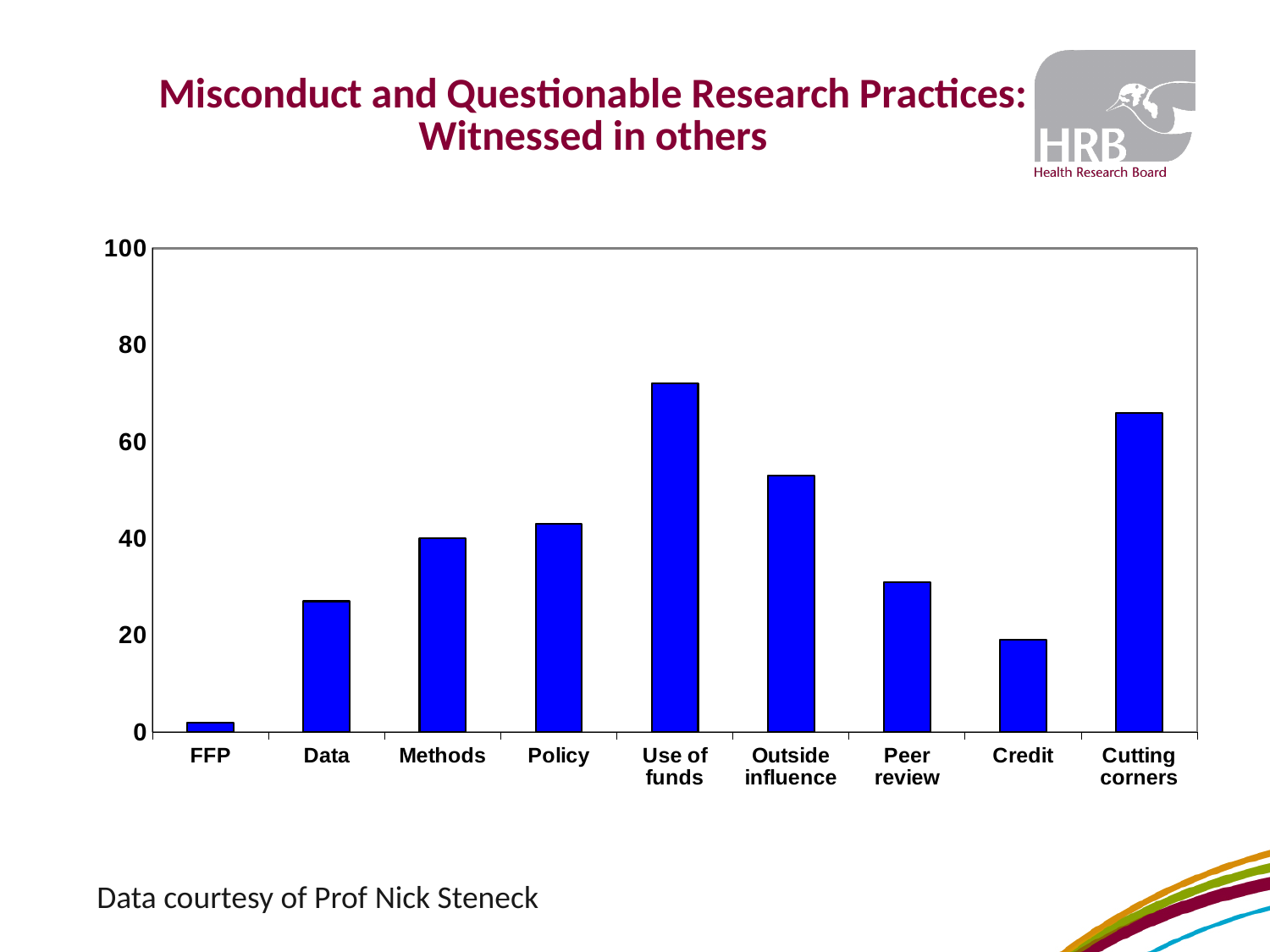
Which is larger, the value for Credit or the value for Peer review? Peer review Is the value for Outside influence greater or less than 40? greater Is the value for Use of funds greater or less than 60? greater Is the value for Cutting corners greater or less than 60? greater Which category has the highest bar? Use of funds Which category has the lowest bar? FFP What kind of chart is shown on the slide? bar chart What is the title of the slide containing the chart? Misconduct and Questionable Research Practices: Witnessed in others How many categories are shown on the x axis of the chart? 9 Which is larger, the value for Outside influence or the value for Policy? Outside influence